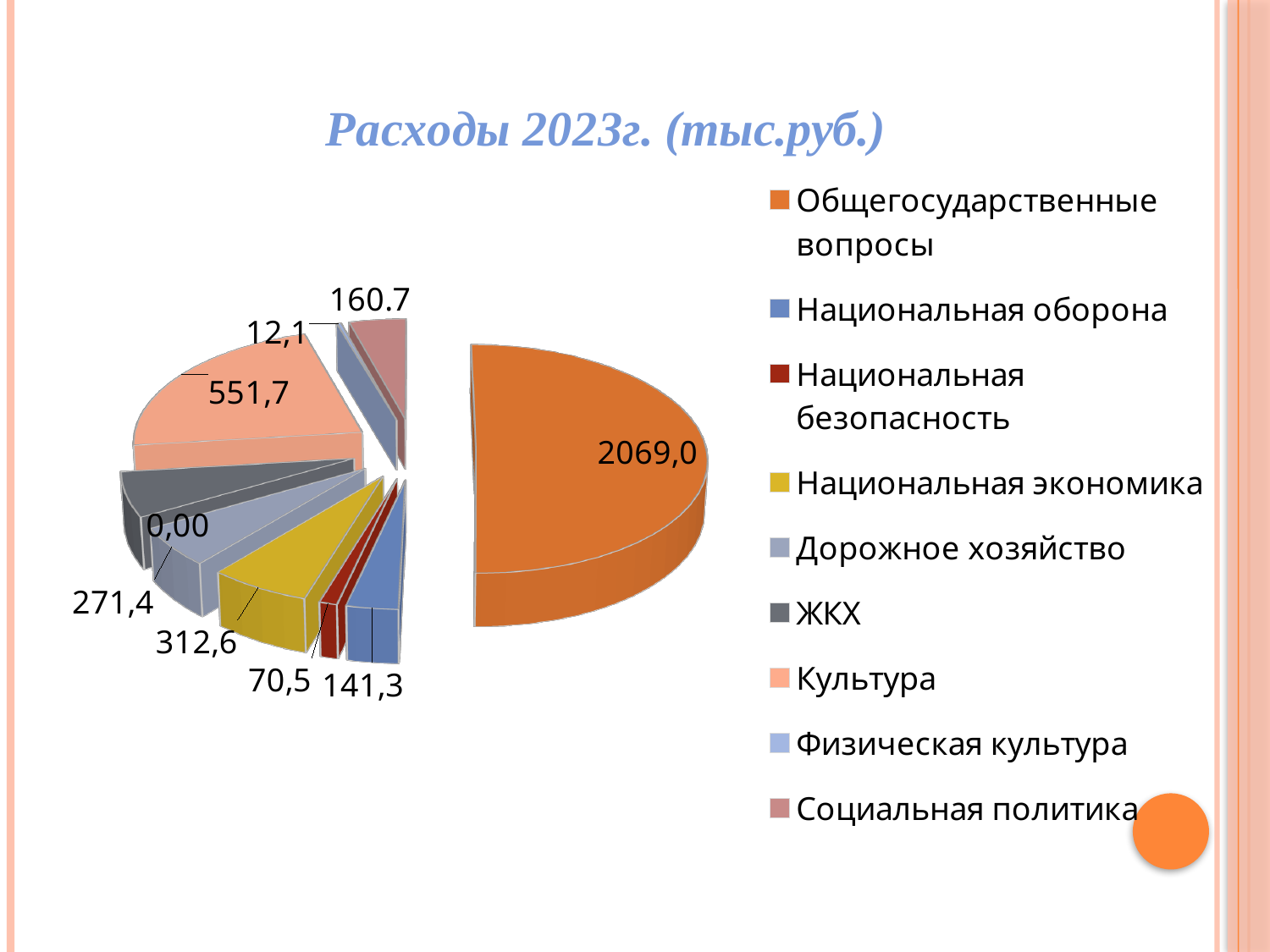
What is the value for Культура? 551,7 What is the value for Физическая культура? 12,1 What is the value for Национальная оборона? 141,3 What is the difference between the values for Культура and Национальная экономика? 239,1 What is the value for Социальная политика? 160.7 How many categories does the legend of the pie chart list? 9 What is the value for Общегосударственные вопросы? 2069,0 What is the title of the chart? Расходы 2023г. (тыс.руб.) What is the value for Национальная безопасность? 70,5 Which category has the largest slice of the pie? Общегосударственные вопросы What kind of chart is shown on the slide? pie chart What is the value for Национальная экономика? 312,6